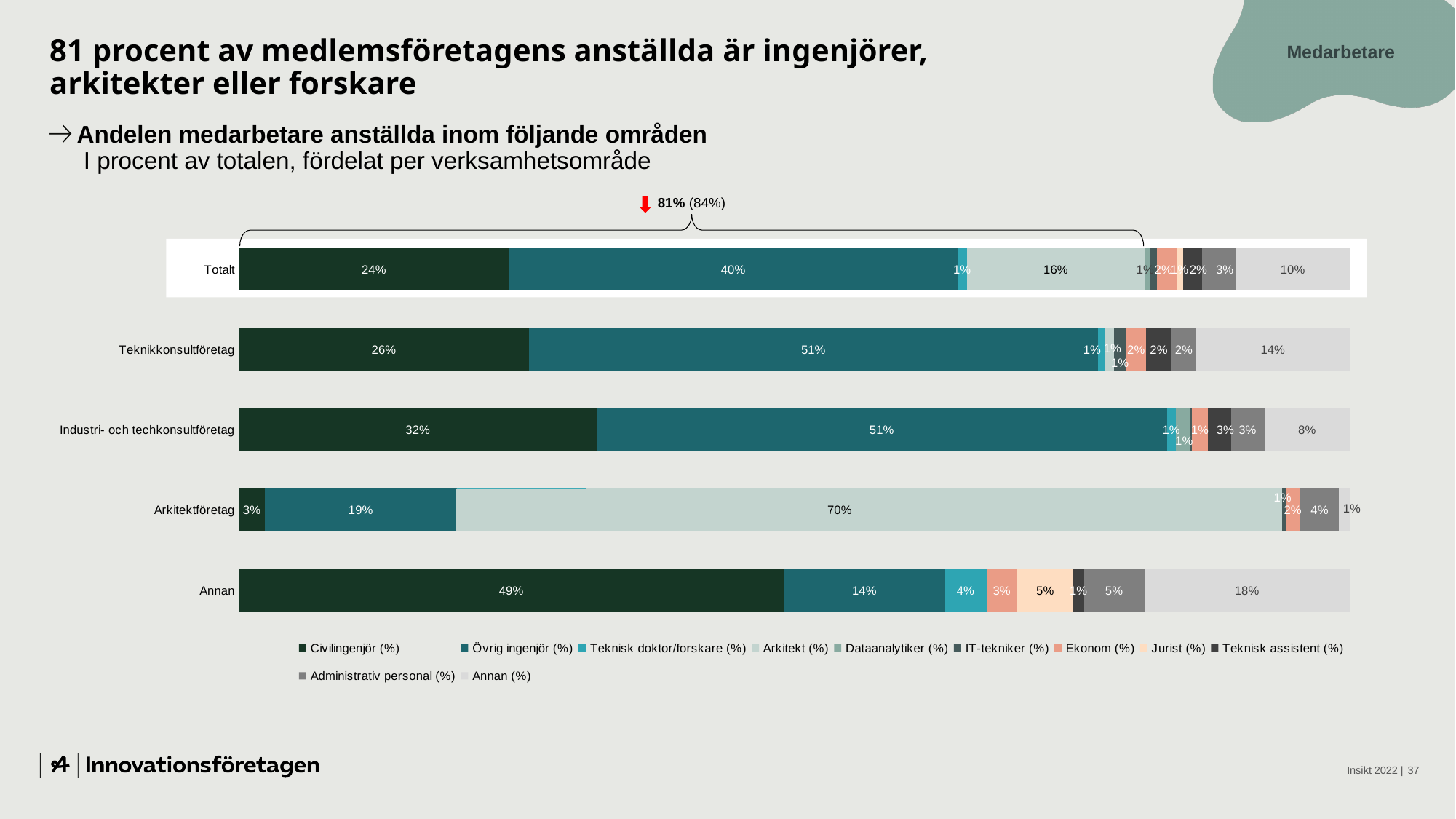
What is the Annan (%) value for the Annan category? 18% What type of chart is shown on the slide? Stacked bar chart Which is larger: the Annan (%) value for Teknikkonsultföretag or for Industri- och techkonsultföretag? Teknikkonsultföretag Which category has the lowest Civilingenjör (%) value? Arkitektföretag Which category has the highest Civilingenjör (%) value? Annan What is the Arkitekt (%) value for Arkitektföretag? 70% What is the Civilingenjör (%) value for Totalt? 24% What is the difference between the Civilingenjör (%) values for Industri- och techkonsultföretag and Teknikkonsultföretag? 6% How many categories (rows) does the chart show? 5 How many series does the legend list? 11 What percentage is highlighted above the bracket over the Totalt bar? 81% (84%) What is the Övrig ingenjör (%) value for Teknikkonsultföretag? 51%